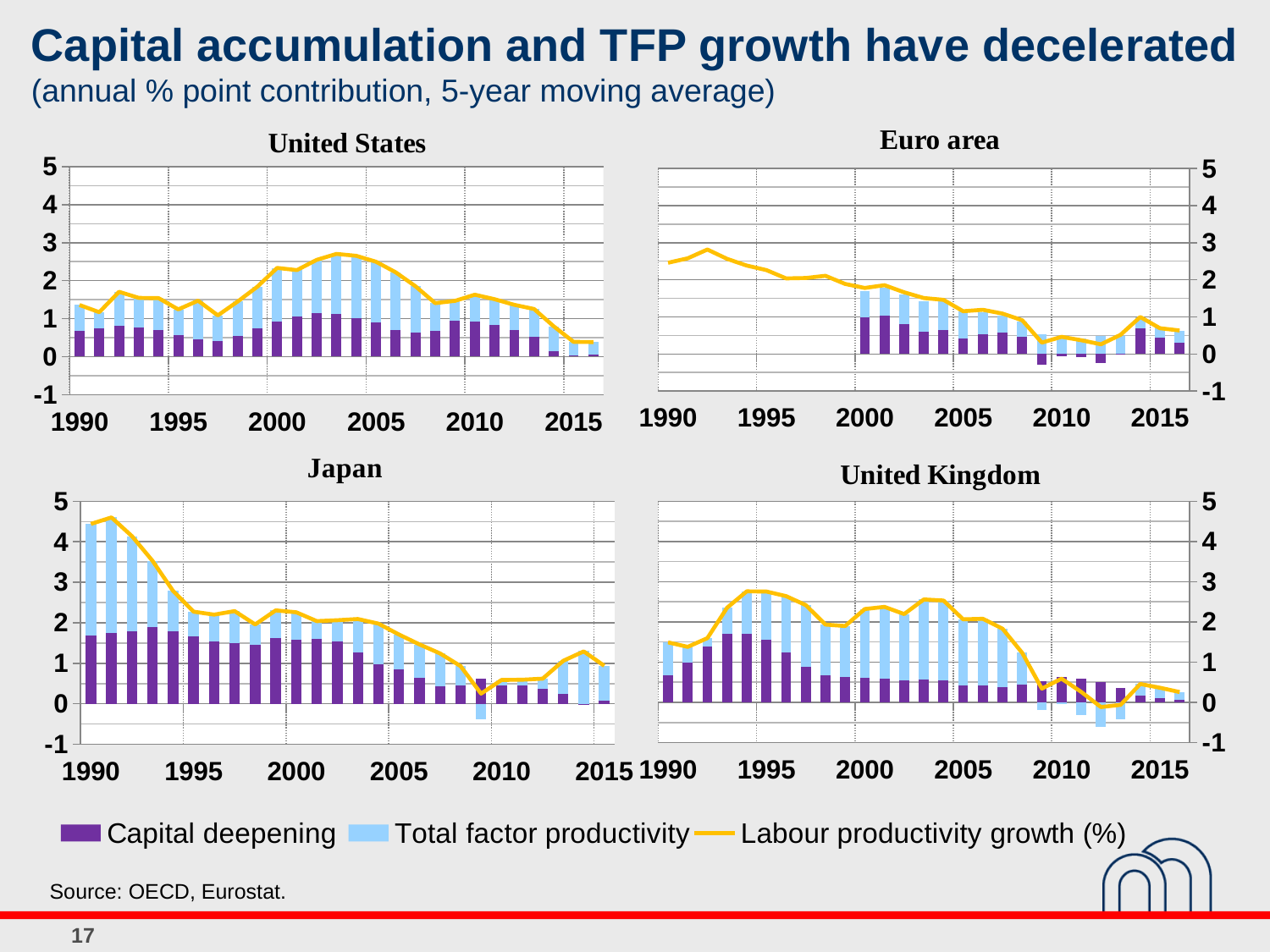
What is the title of the chart in the bottom-right position? United Kingdom In the Japan chart, does labour productivity growth generally rise or fall from 1990 to 2015? fall Which is larger in 1990: labour productivity growth in the Japan chart or in the United States chart? Japan In the Japan chart, is the labour productivity growth value for 1990 greater or less than 4? greater In the United Kingdom chart, is the labour productivity growth value for 1995 greater or less than 2? greater Which series is shown as a yellow line in the charts? Labour productivity growth (%) What kind of chart is the United States chart? A combined bar and line chart In the United States chart, is the labour productivity growth value for 2003 greater or less than 2? greater How many charts are shown on the slide? 4 How many series does the legend list? 3